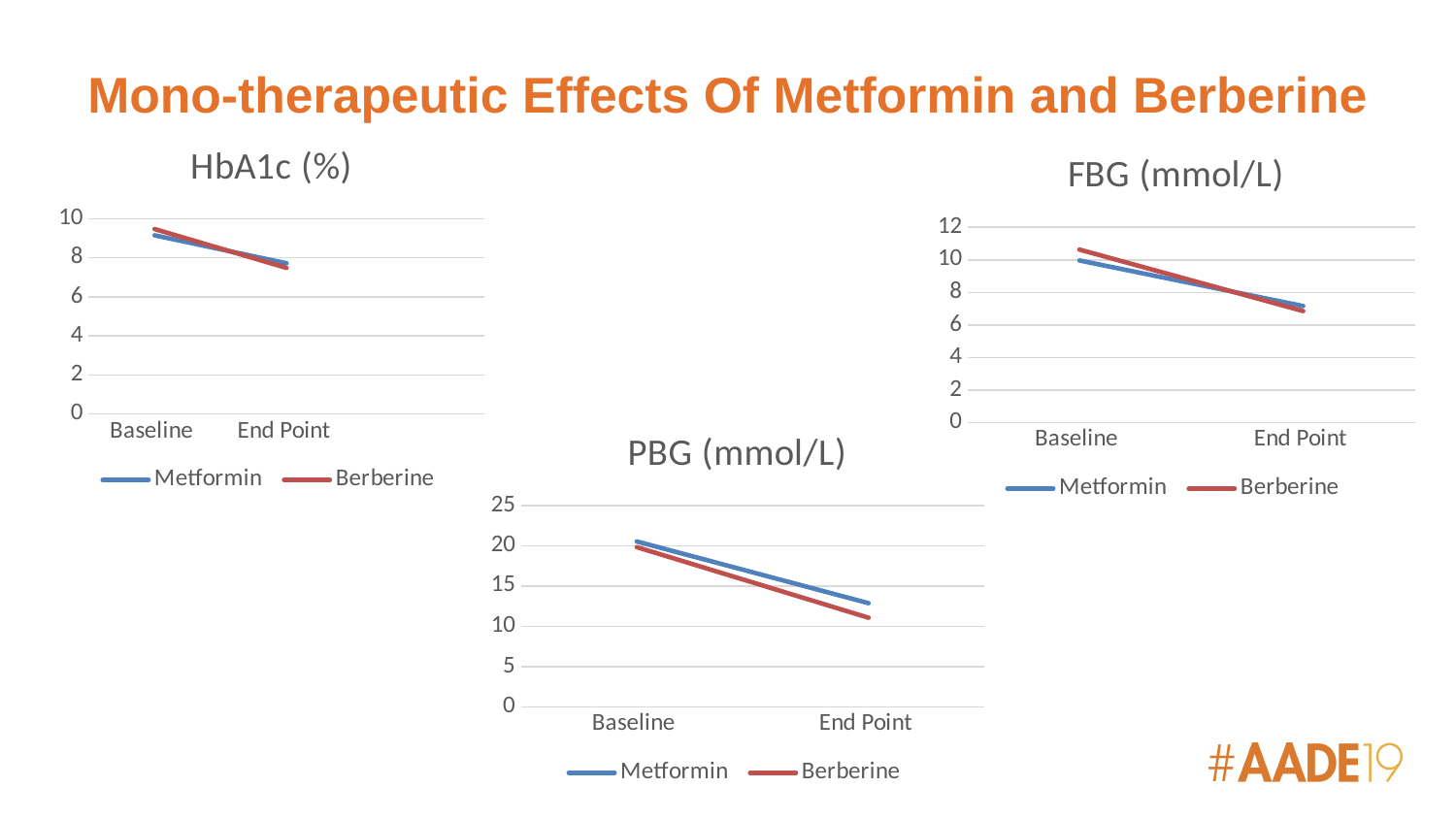
In the PBG (mmol/L) chart, is the End Point value for Berberine greater or less than 15? less In the FBG (mmol/L) chart, which series has the larger Baseline value, Metformin or Berberine? Berberine What colour is the Berberine line in the PBG (mmol/L) chart? red How many points are on the x axis of the PBG (mmol/L) chart? 2 In the HbA1c (%) chart, do the values for Metformin rise or fall from Baseline to End Point? fall In the HbA1c (%) chart, is the Baseline value for Metformin greater or less than 8? greater What kind of chart is the HbA1c (%) chart? line chart In the FBG (mmol/L) chart, is the End Point value for Metformin greater or less than 8? less In the PBG (mmol/L) chart, do the values for Berberine rise or fall from Baseline to End Point? fall How many series does the legend of the FBG (mmol/L) chart list? 2 In the PBG (mmol/L) chart, which series has the larger End Point value, Metformin or Berberine? Metformin